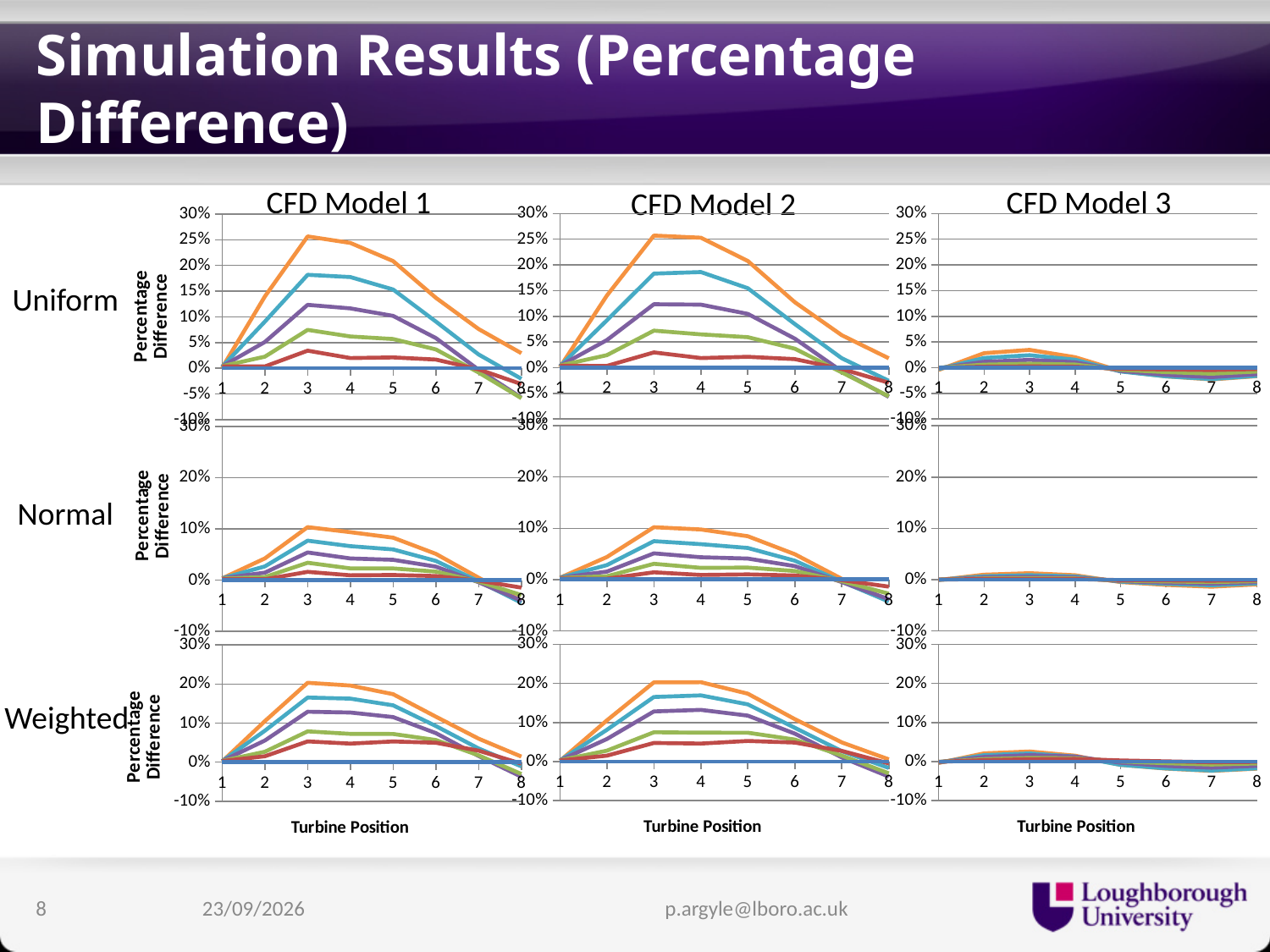
How many charts are shown on the slide in total? 9 In the Uniform / CFD Model 1 chart, is the value of the orange line at turbine position 3 greater or less than 20%? greater What is the y-axis label on the charts? Percentage Difference Which CFD model column shows the smallest percentage differences across all three rows? CFD Model 3 What is the x-axis label on the charts? Turbine Position How many turbine positions are shown on the x axis of the Weighted / CFD Model 2 chart? 8 In the Weighted / CFD Model 2 chart, does the orange line rise or fall from turbine position 1 to turbine position 3? rise In the Uniform / CFD Model 3 chart, is the peak value of the orange line greater or less than 5%? less In the Weighted / CFD Model 1 chart, is the value of the orange line at turbine position 3 greater or less than 10%? greater What kind of chart is used in the Uniform / CFD Model 1 panel? line chart In the Uniform / CFD Model 1 chart, does the orange line rise or fall from turbine position 3 to turbine position 8? fall